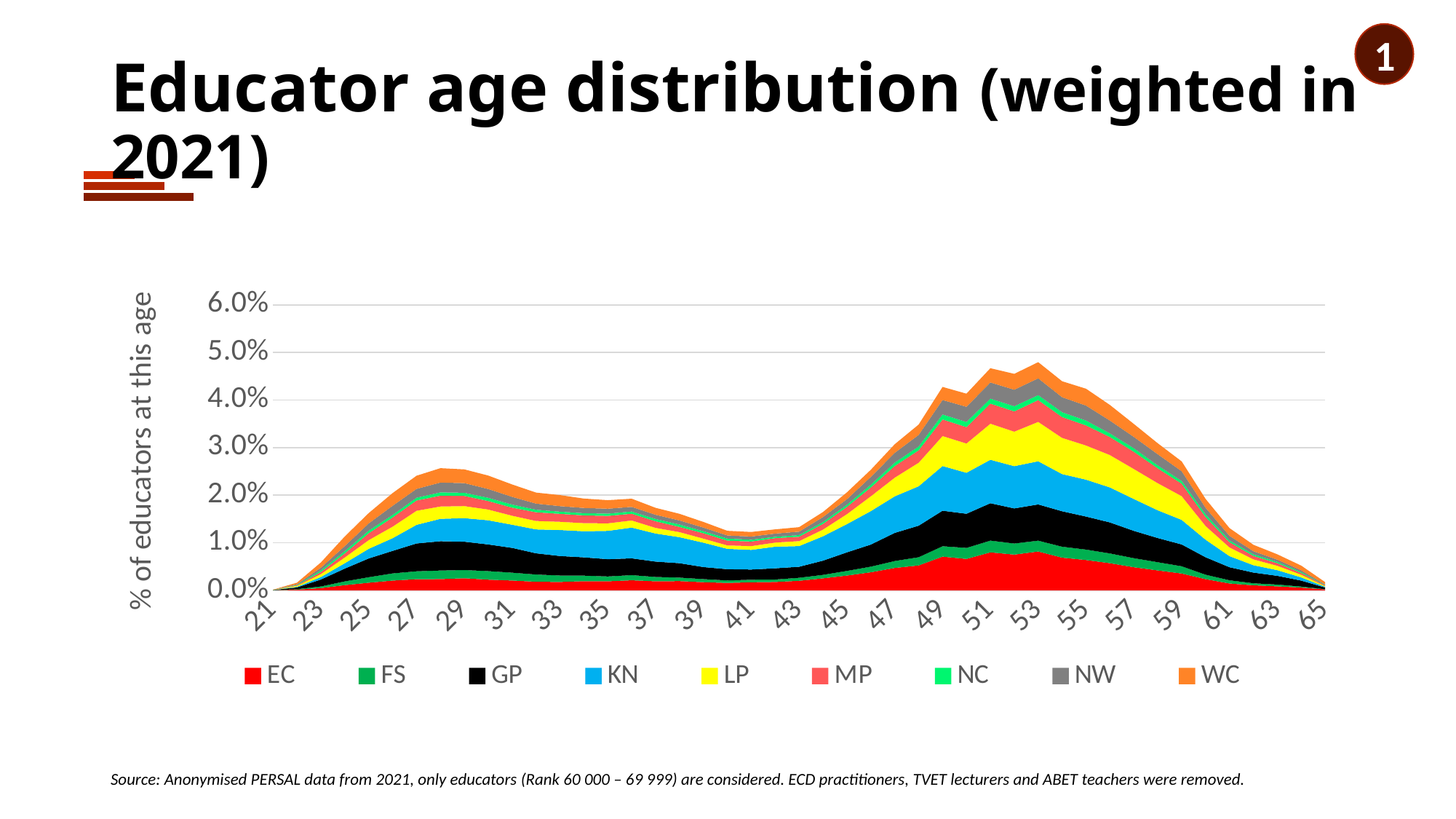
What is the label on the vertical axis? % of educators at this age Which is larger, the total value at age 41 or at age 29? age 29 Is the total value for age 65 greater or less than 1.0%? less Is the total value for age 29 greater or less than 2.0%? greater Do the total values rise or fall between age 41 and age 53? rise Is the total value for age 41 greater or less than 2.0%? less What kind of chart is shown on the slide? stacked area chart Which is larger, the total value at age 29 or at age 53? age 53 How many series does the legend list? 9 Which colour represents the EC series? red What is the highest value shown on the vertical axis? 6.0%